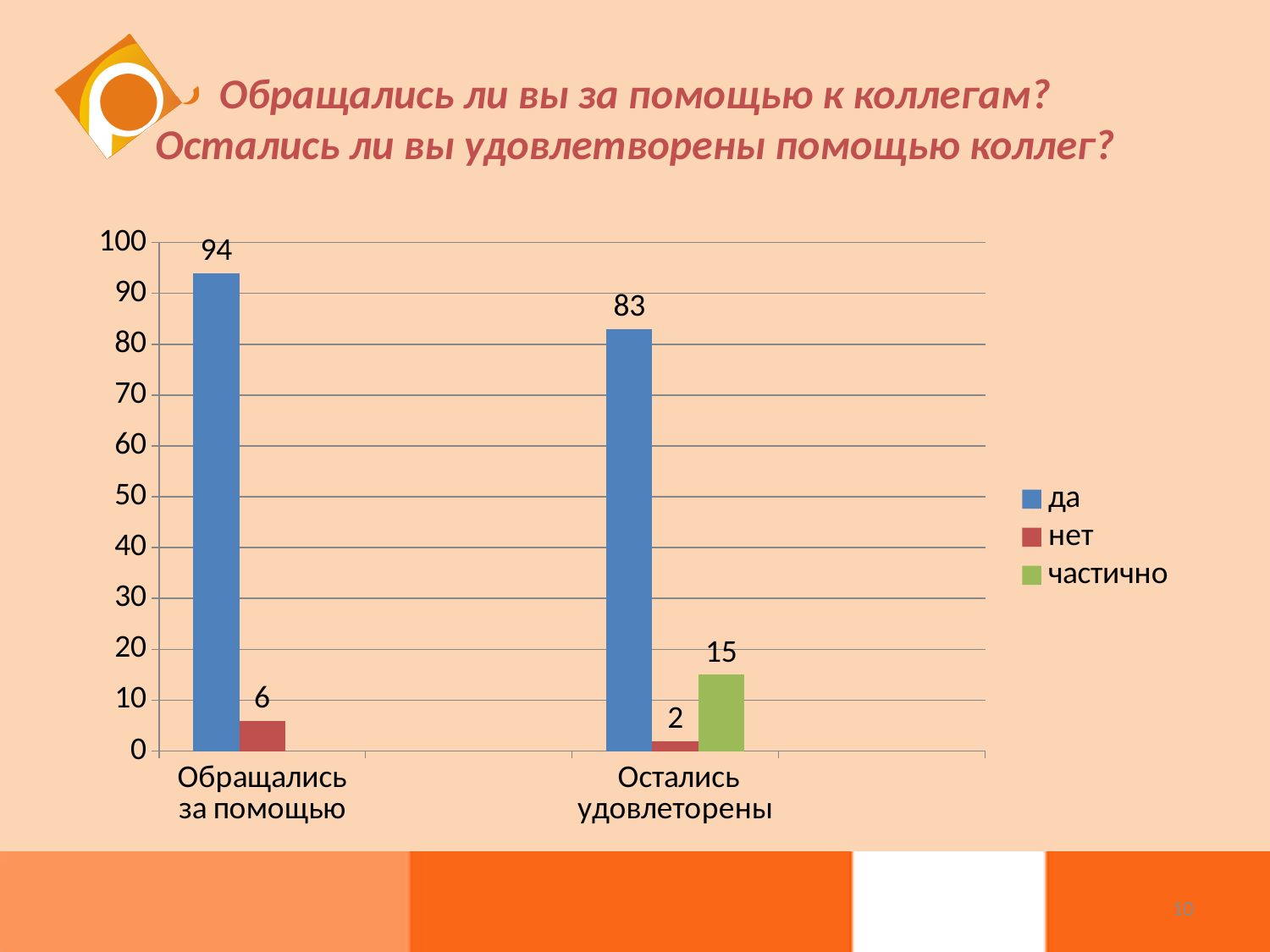
What is the value for "частично" in the "Остались удовлеторены" category? 15 What kind of chart is shown on the slide? bar chart What is the value for "да" in the "Обращались за помощью" category? 94 Which is larger: the "нет" value for "Обращались за помощью" or the "частично" value for "Остались удовлеторены"? частично for Остались удовлеторены Which series has the lowest value in the "Остались удовлеторены" category? нет How many categories are shown on the x axis? 2 What is the value for "нет" in the "Остались удовлеторены" category? 2 What colour represents the "частично" series in the legend? green Which series has the highest value in the "Остались удовлеторены" category? да What is the value for "нет" in the "Обращались за помощью" category? 6 What is the difference between the "да" values for "Обращались за помощью" and "Остались удовлеторены"? 11 How many series does the legend list? 3